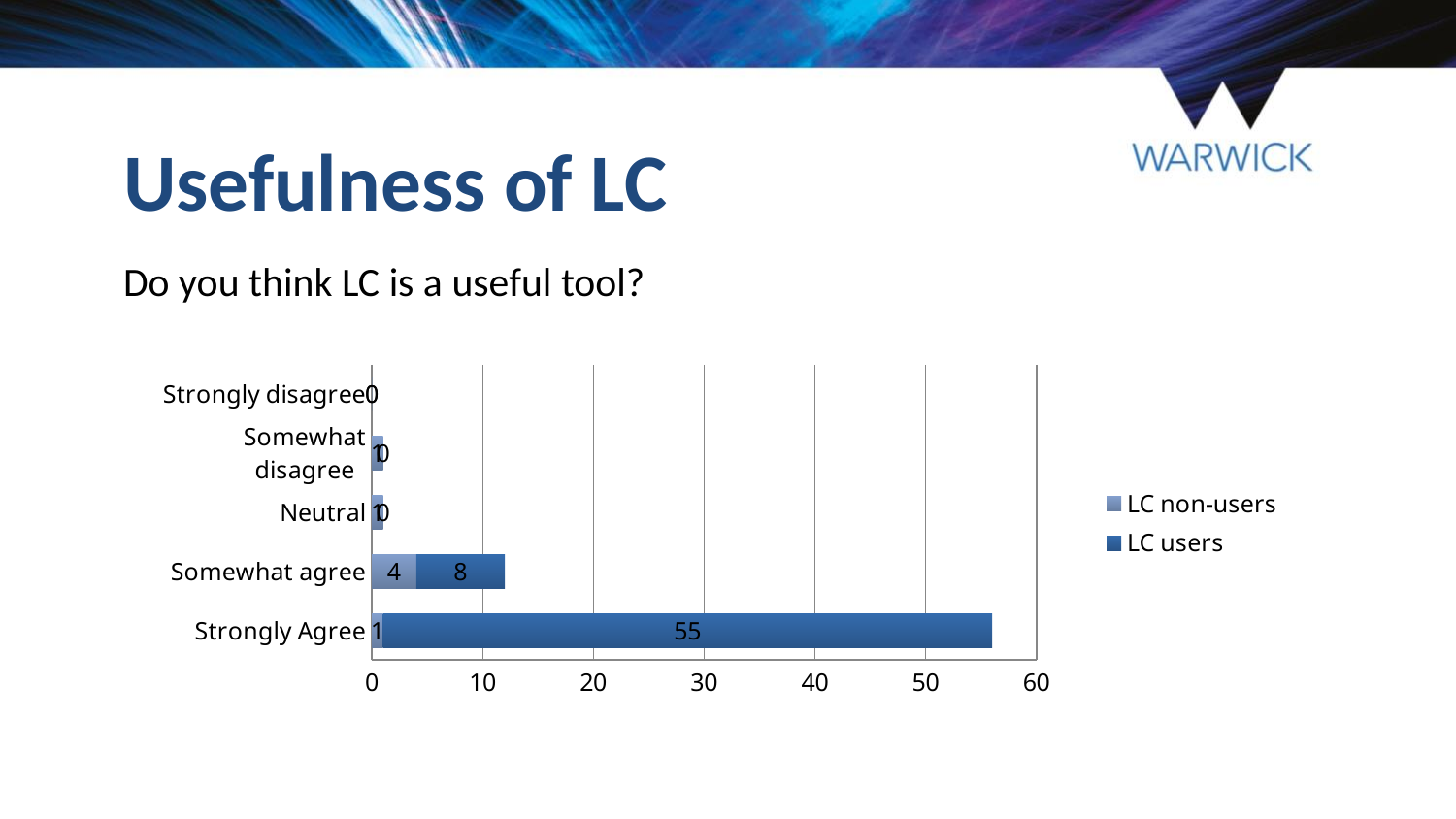
What is the value for LC non-users in the Strongly Agree category? 1 What is the value for LC users in the Somewhat agree category? 8 Which category has the highest value for LC users? Strongly Agree What kind of chart is shown on the slide? Bar chart What is the value for LC non-users in the Somewhat agree category? 4 Which is larger for the Somewhat agree category: LC users or LC non-users? LC users What is the total of the stacked bar for Strongly Agree? 56 How many series does the legend list? 2 Is the total value of the Strongly Agree bar greater or less than 50? greater What is the value for LC users in the Strongly Agree category? 55 What is the total of the stacked bar for Somewhat agree? 12 What is the difference between the LC users values for Strongly Agree and Somewhat agree? 47